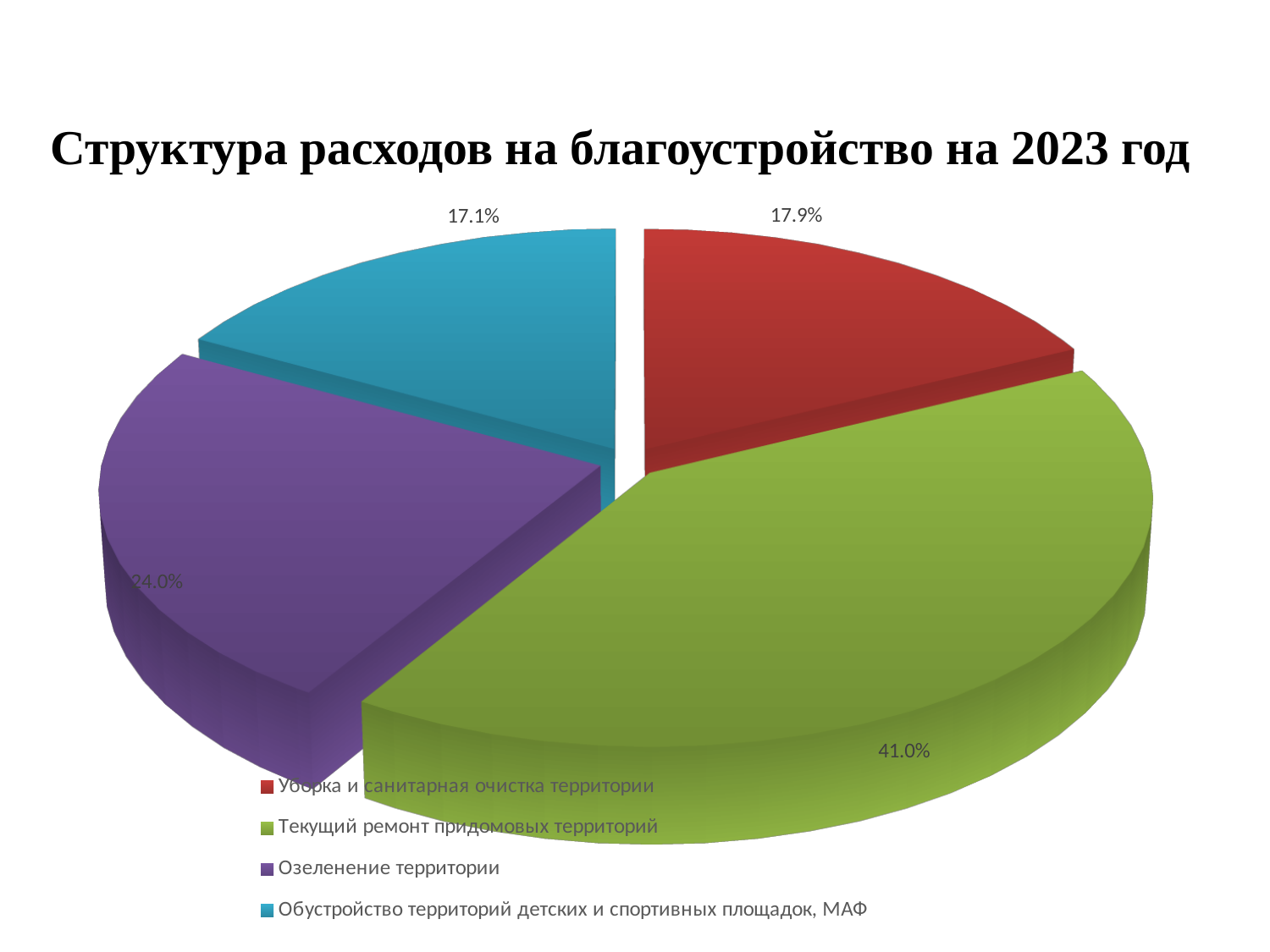
Какая категория имеет наименьшую долю расходов? Обустройство территорий детских и спортивных площадок, МАФ Какой тип диаграммы показан на слайде? Круговая диаграмма Каким цветом обозначена категория «Озеленение территории»? Фиолетовым Как называется диаграмма на слайде? Структура расходов на благоустройство на 2023 год Какую долю занимает «Текущий ремонт придомовых территорий» на диаграмме? 41.0% Какую долю занимает «Уборка и санитарная очистка территории»? 17.9% Какую долю занимает «Озеленение территории»? 24.0% Какая категория имеет наибольшую долю расходов? Текущий ремонт придомовых территорий На сколько процентных пунктов доля «Текущий ремонт придомовых территорий» больше доли «Озеленение территории»? 17.0 Сколько категорий показано на диаграмме? 4 Какую долю занимает «Обустройство территорий детских и спортивных площадок, МАФ»? 17.1% Что больше: доля «Озеленение территории» или доля «Уборка и санитарная очистка территории»? Озеленение территории